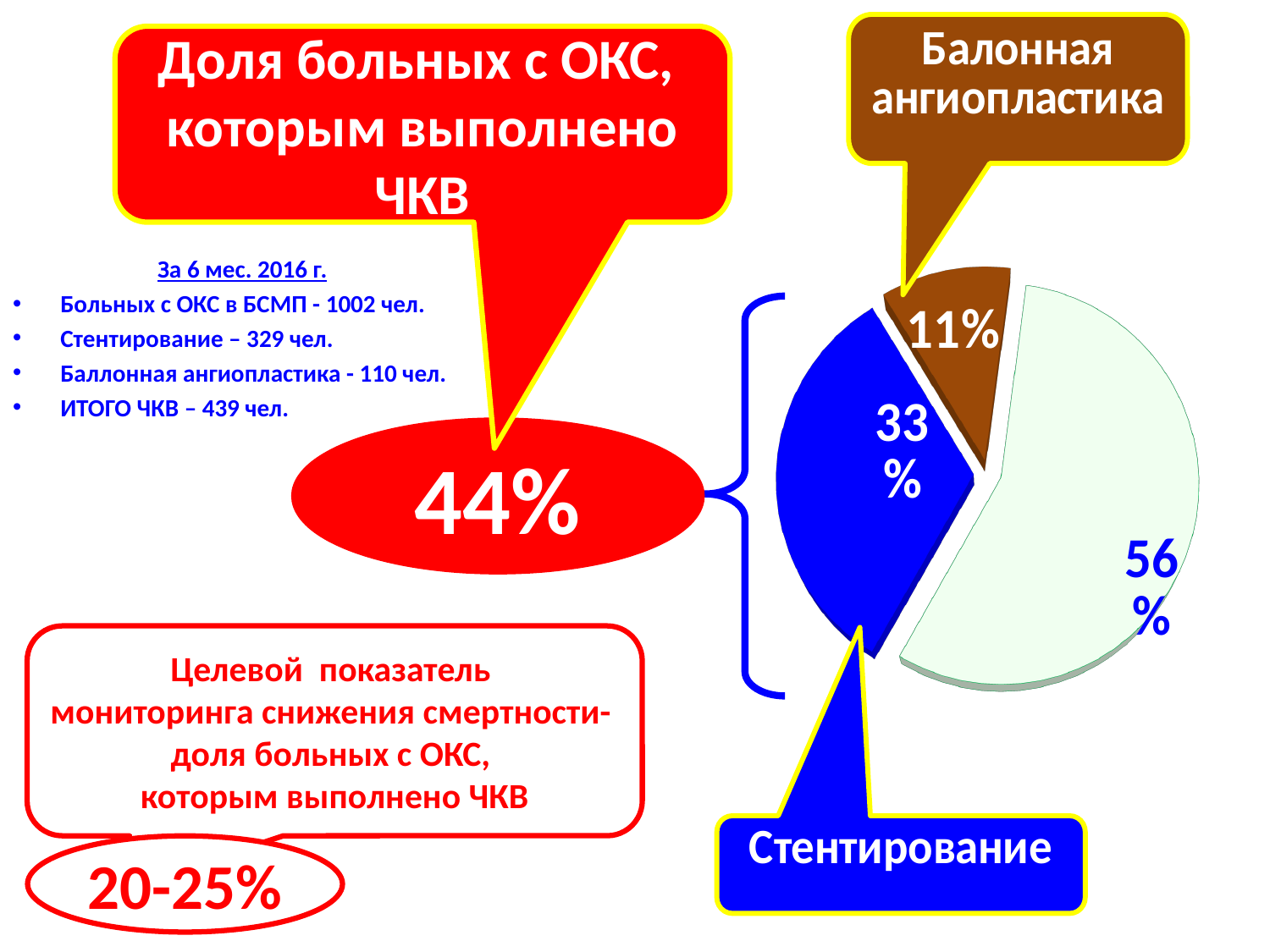
Which slice of the pie chart is the smallest? Балонная ангиопластика (11%) What colour is the slice labelled Стентирование? blue What share of the pie does the slice labelled Балонная ангиопластика (brown) represent? 11% What colour is the slice labelled Балонная ангиопластика? brown What is the combined share of the Стентирование and Балонная ангиопластика slices? 44% What kind of chart is shown on the slide? pie chart Which slice of the pie chart is the largest? the light green slice (56%) How many slices does the pie chart have? 3 What is the difference between the Стентирование slice and the Балонная ангиопластика slice? 22% What percentage is shown on the largest, light green slice of the pie chart? 56% Which is larger in the pie chart: the Стентирование slice or the Балонная ангиопластика slice? Стентирование What share of the pie does the slice labelled Стентирование (blue) represent? 33%